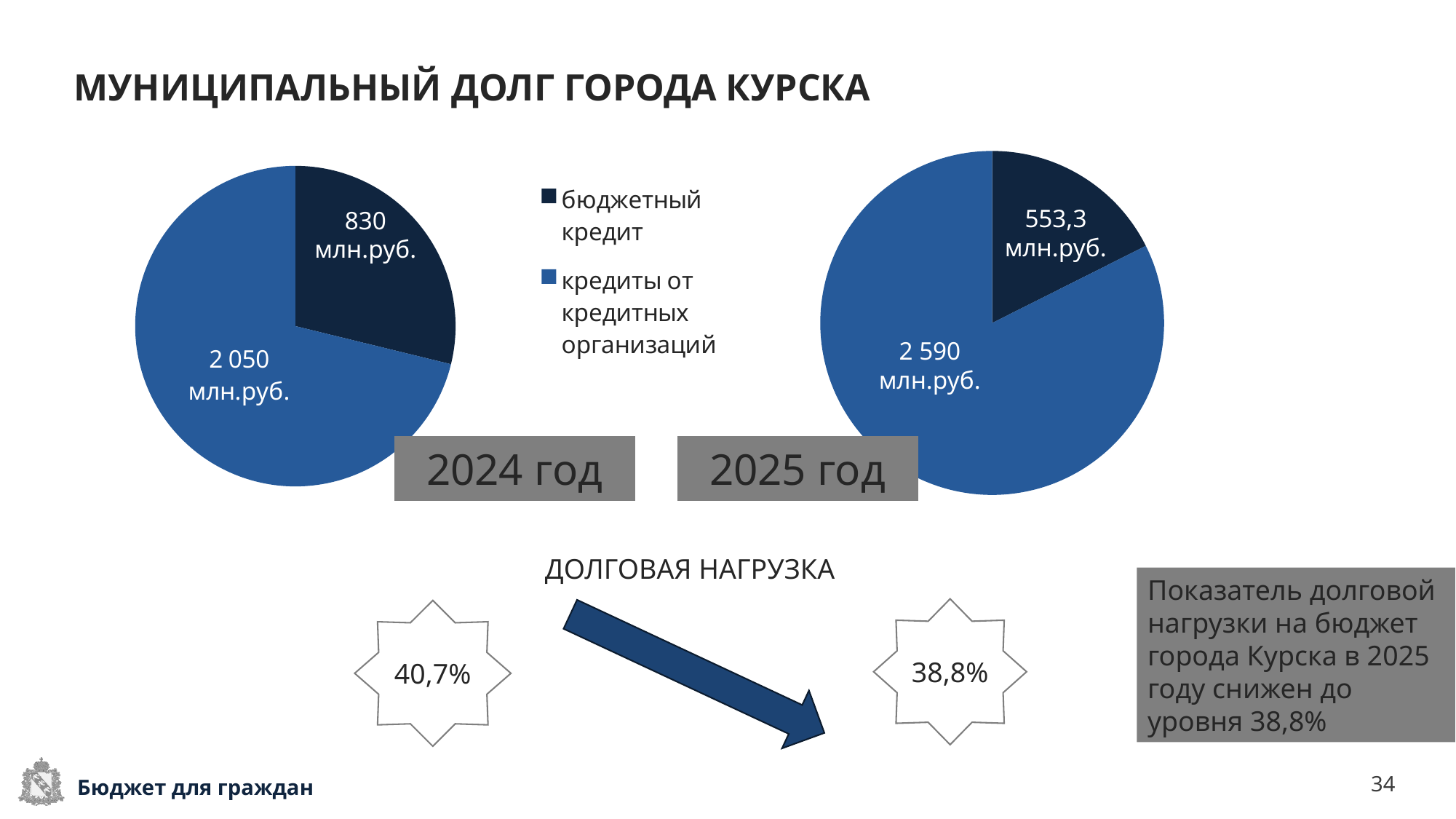
How many series does the legend list? 2 In the 2025 pie chart, what is the value for бюджетный кредит? 553,3 млн.руб. In the 2025 pie chart, what is the value for кредиты от кредитных организаций? 2 590 млн.руб. Which is larger: бюджетный кредит in the 2024 chart or бюджетный кредит in the 2025 chart? 2024 What type of chart is used to show the 2024 and 2025 debt structure? pie chart What is the total of the two slices in the 2025 pie chart? 3 143,3 млн.руб. In the 2024 pie chart, what is the value for бюджетный кредит? 830 млн.руб. How many slices does the 2024 pie chart have? 2 In the 2025 pie chart, which category is the largest? кредиты от кредитных организаций In the 2024 pie chart, what is the value for кредиты от кредитных организаций? 2 050 млн.руб. In the 2024 pie chart, what is the difference between кредиты от кредитных организаций and бюджетный кредит? 1 220 млн.руб. In the 2024 pie chart, which category is the smallest? бюджетный кредит